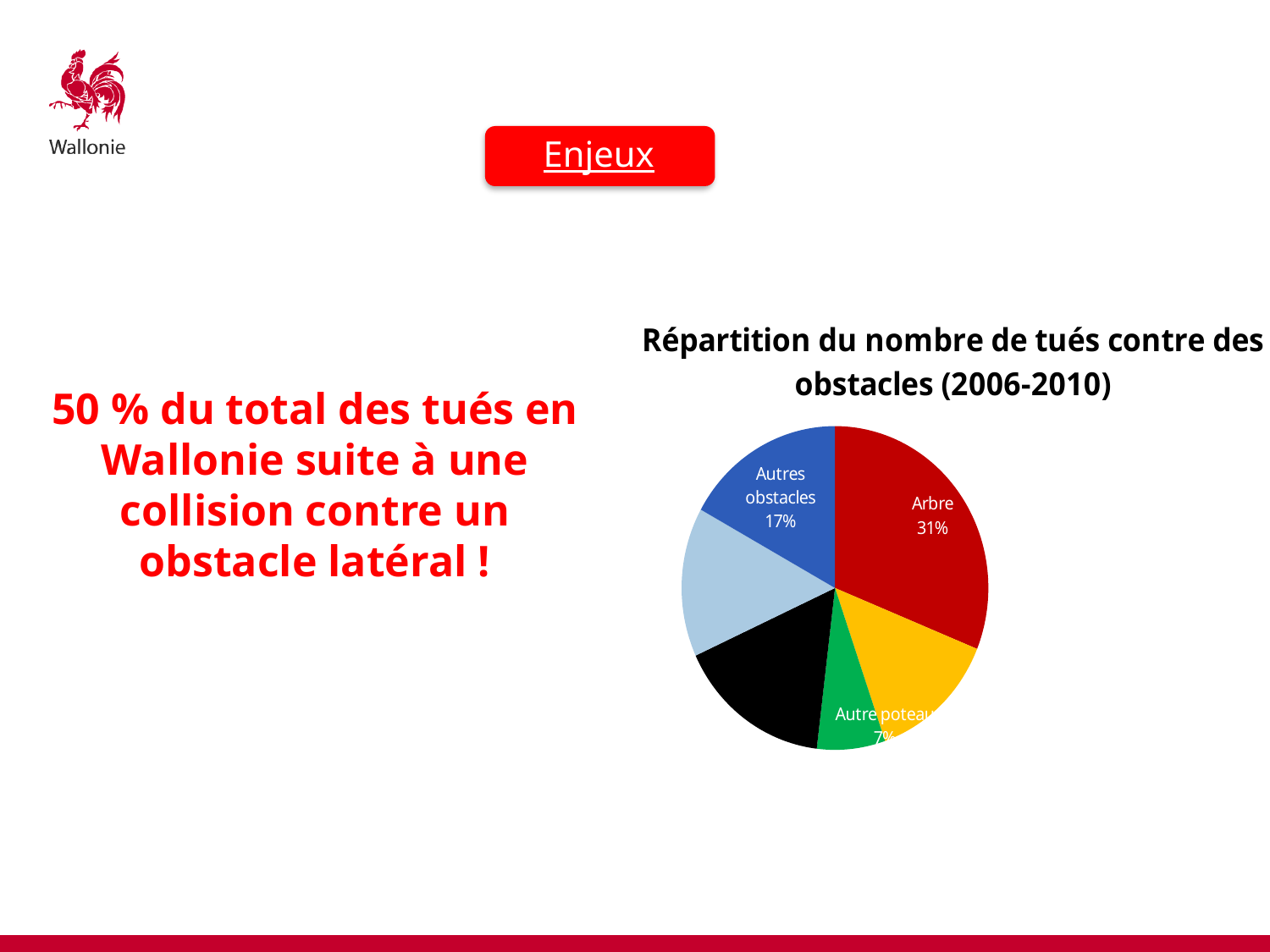
Which is larger, the Arbre slice or the Autre poteau slice? Arbre What is the difference in percentage points between the Arbre slice and the Autres obstacles slice? 14 How many slices does the pie chart have? 6 What share of the pie does the Arbre slice represent? 31% What colour is the Arbre slice? red What kind of chart is shown on the slide? pie chart What percentage is shown for Autres obstacles? 17% Which category has the largest slice of the pie? Arbre What is the title of the chart? Répartition du nombre de tués contre des obstacles (2006-2010) Which is larger, the Arbre slice or the Autres obstacles slice? Arbre